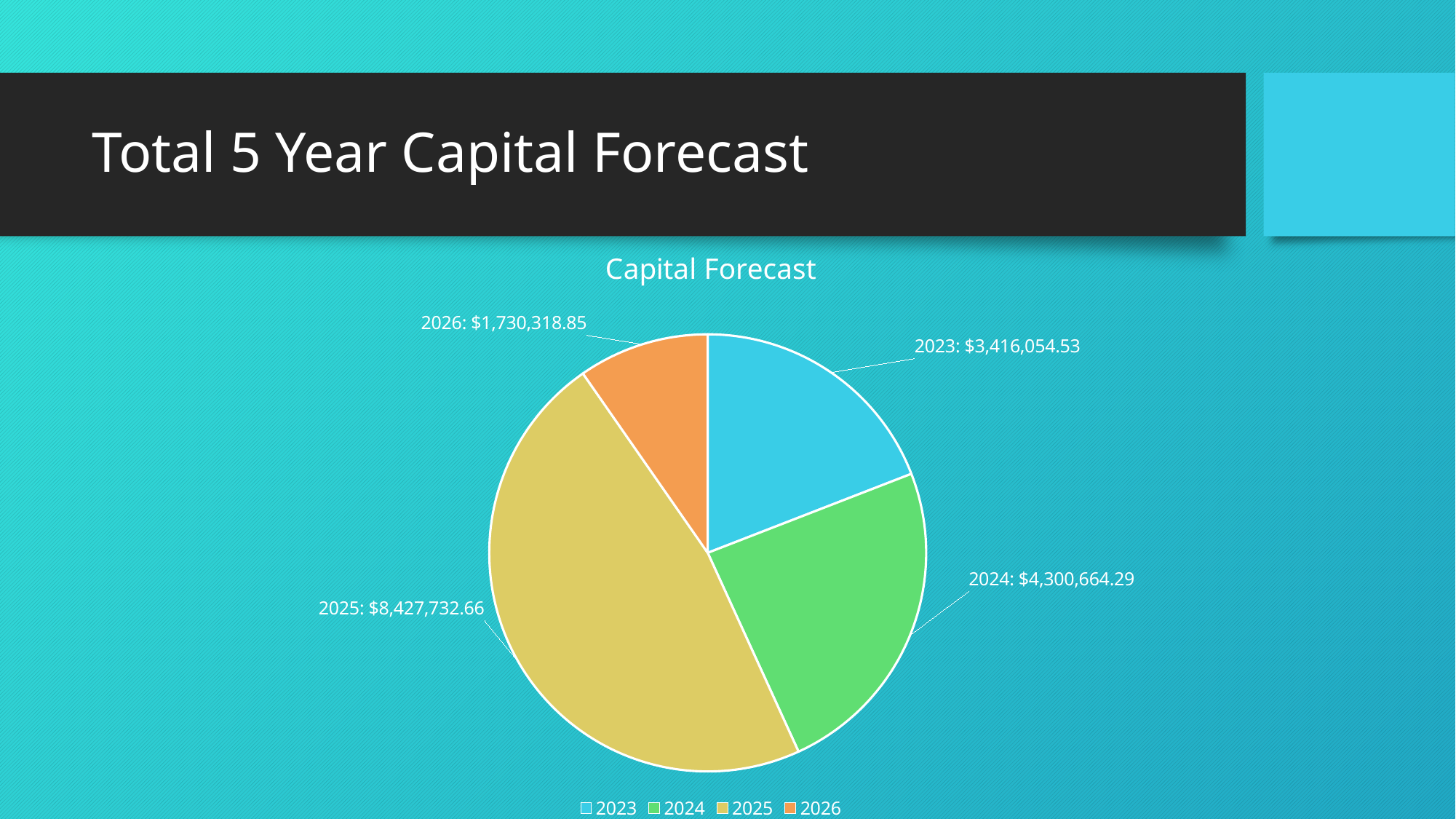
Which year has the smallest slice of the pie? 2026 How many slices does the pie chart have? 4 How many entries does the legend list? 4 What is the title of the chart? Capital Forecast What is the capital forecast value for 2025? $8,427,732.66 What is the capital forecast value for 2026? $1,730,318.85 What type of chart is shown on the slide? pie chart What is the capital forecast value for 2023? $3,416,054.53 What is the difference between the 2024 value and the 2023 value? $884,609.76 Which year has the largest slice of the pie? 2025 Which is larger, the value for 2023 or the value for 2024? 2024 What is the difference between the 2025 value and the 2024 value? $4,127,068.37